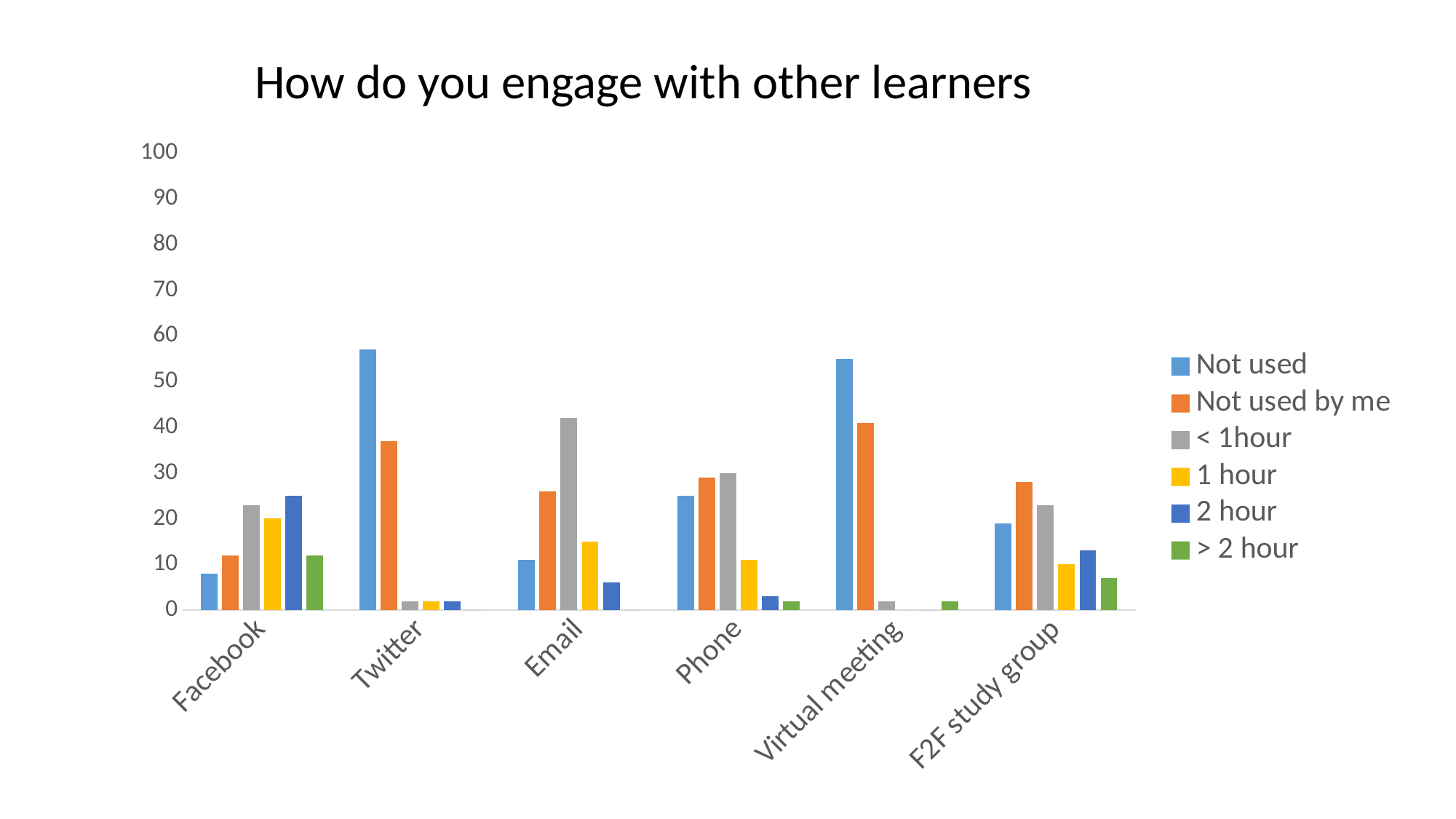
How many series does the legend list? 6 Is the "Not used" value for Twitter greater or less than 50? greater How many categories are shown on the x axis of the chart? 6 Which series has the highest value for Virtual meeting? Not used Which series has the highest value for Email? < 1hour Which is larger for Phone: the "Not used by me" value or the "1 hour" value? Not used by me Is the "< 1hour" value for Email greater or less than 40? greater Is the "Not used" value for Facebook greater or less than 10? less What kind of chart is shown on the slide? bar chart Which colour represents the "> 2 hour" series in the legend? green What is the title of the chart? How do you engage with other learners